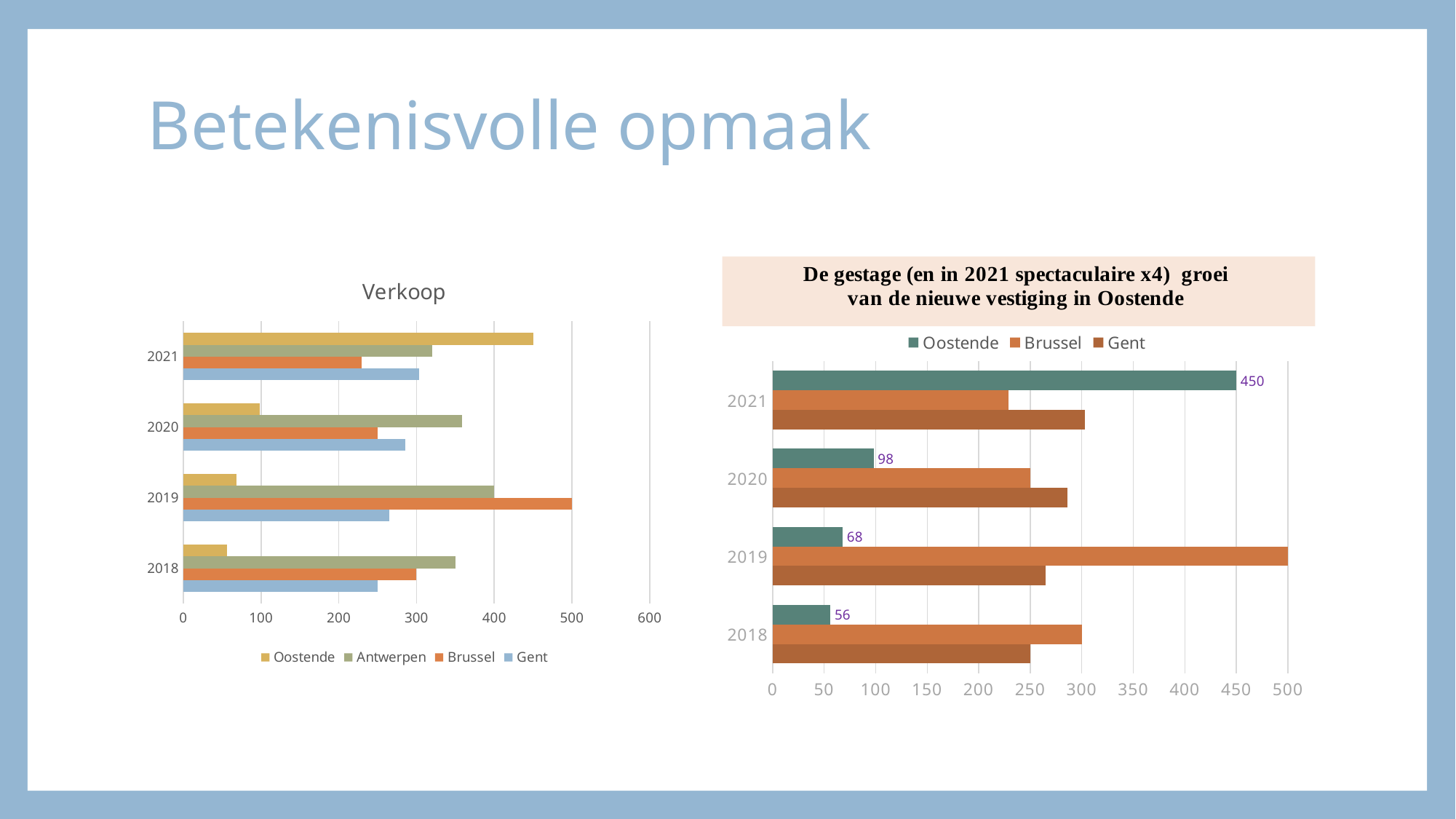
How many series does the legend of the right-hand chart list? 3 What kind of chart is the left-hand chart 'Verkoop'? bar chart How many series does the legend of the left-hand chart 'Verkoop' list? 4 How many years are shown on the left-hand chart 'Verkoop'? 4 In the right-hand chart, do the Oostende values rise or fall from 2018 to 2021? rise In the left-hand chart 'Verkoop', which series has the highest value in 2019? Brussel In the right-hand chart, which is larger in 2021: Oostende or Brussel? Oostende In the left-hand chart 'Verkoop', is the value for Brussel in 2019 greater or less than 400? greater In the right-hand chart, what is the difference between the Oostende values for 2021 and 2020? 352 In the right-hand chart, what is the value for Oostende in 2021? 450 In the right-hand chart, what is the value for Oostende in 2020? 98 In the right-hand chart, what is the value for Oostende in 2018? 56